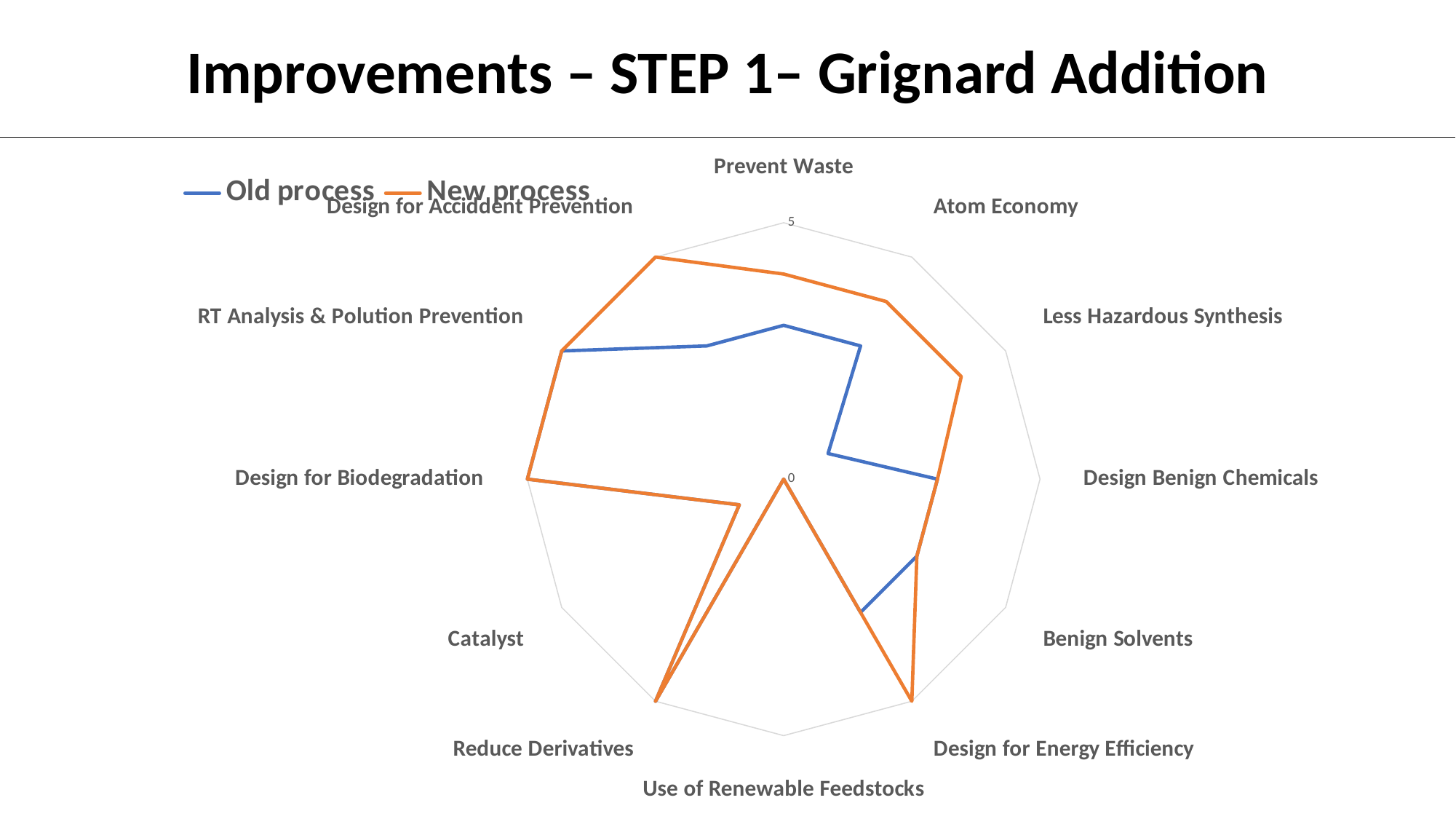
What is the value for New process at Design for Energy Efficiency? 5 At Design for Acciddent Prevention, which series has the larger value, Old process or New process? New process At Prevent Waste, which series has the larger value, Old process or New process? New process What are the two series named in the legend? Old process and New process At Less Hazardous Synthesis, which series has the larger value, Old process or New process? New process How many categories (axes) does the radar chart have? 12 What is the maximum value shown on the chart's axis scale? 5 How many series does the legend list? 2 What is the value for New process at Reduce Derivatives? 5 What is the value for New process at Use of Renewable Feedstocks? 0 Is the value for Old process at Less Hazardous Synthesis greater or less than 5? less What kind of chart is shown on the slide? Radar chart